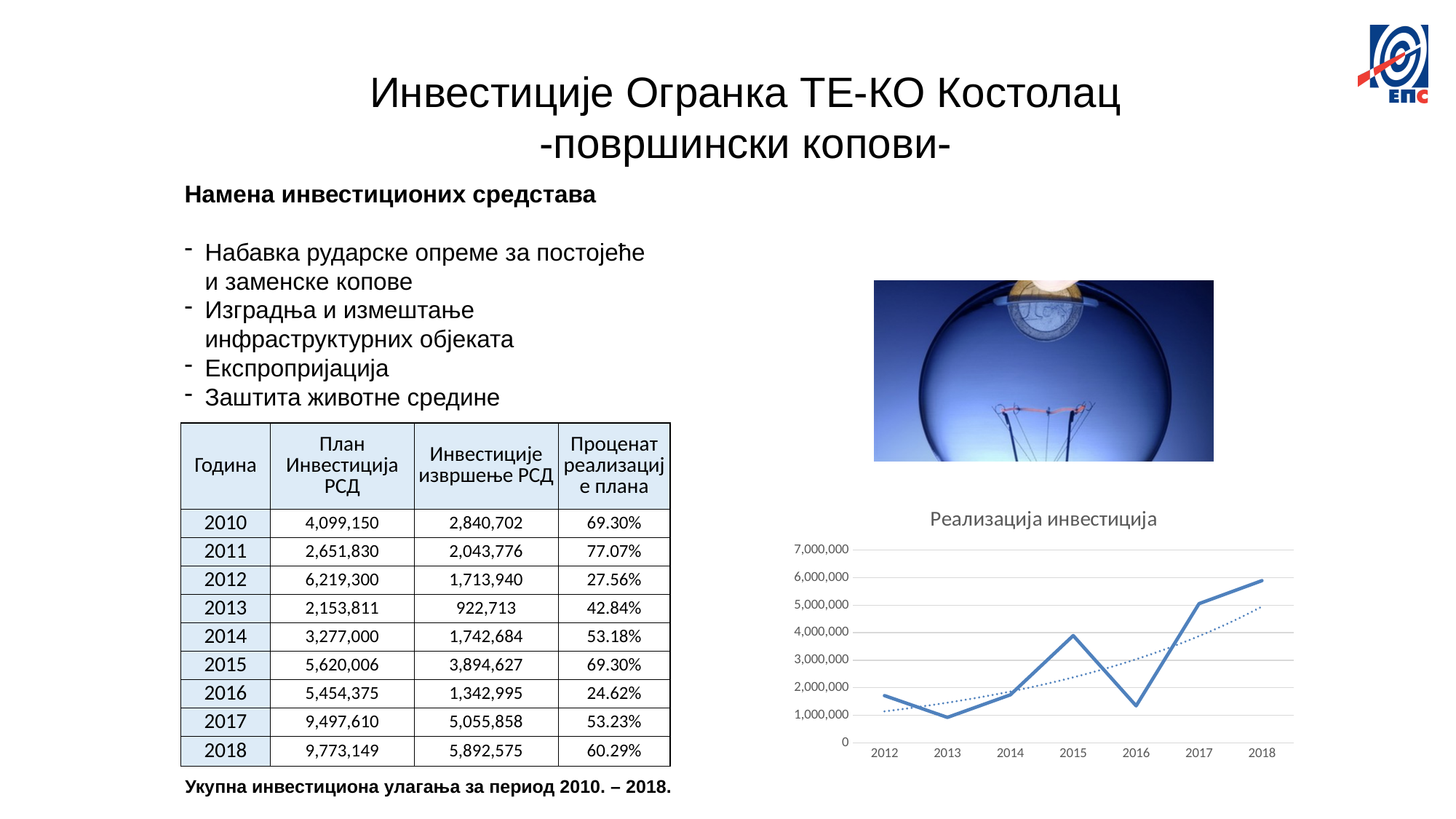
What is the title of the chart on the right side of the slide? Реализација инвестиција In the "Реализација инвестиција" chart, is the value for 2014 greater or less than 2,000,000? less In the "Реализација инвестиција" chart, does the dotted trend line rise or fall from 2012 to 2018? rise In the "Реализација инвестиција" chart, which year has the larger value, 2015 or 2016? 2015 What type of chart is shown under the title "Реализација инвестиција"? line chart In the "Реализација инвестиција" chart, is the value for 2017 greater or less than 4,000,000? greater In the "Реализација инвестиција" chart, which year has the highest value on the solid line? 2018 In the "Реализација инвестиција" chart, is the value for 2012 greater or less than 1,000,000? greater In the "Реализација инвестиција" chart, which year has the lowest value on the solid line? 2013 How many years are plotted on the x axis of the "Реализација инвестиција" chart? 7